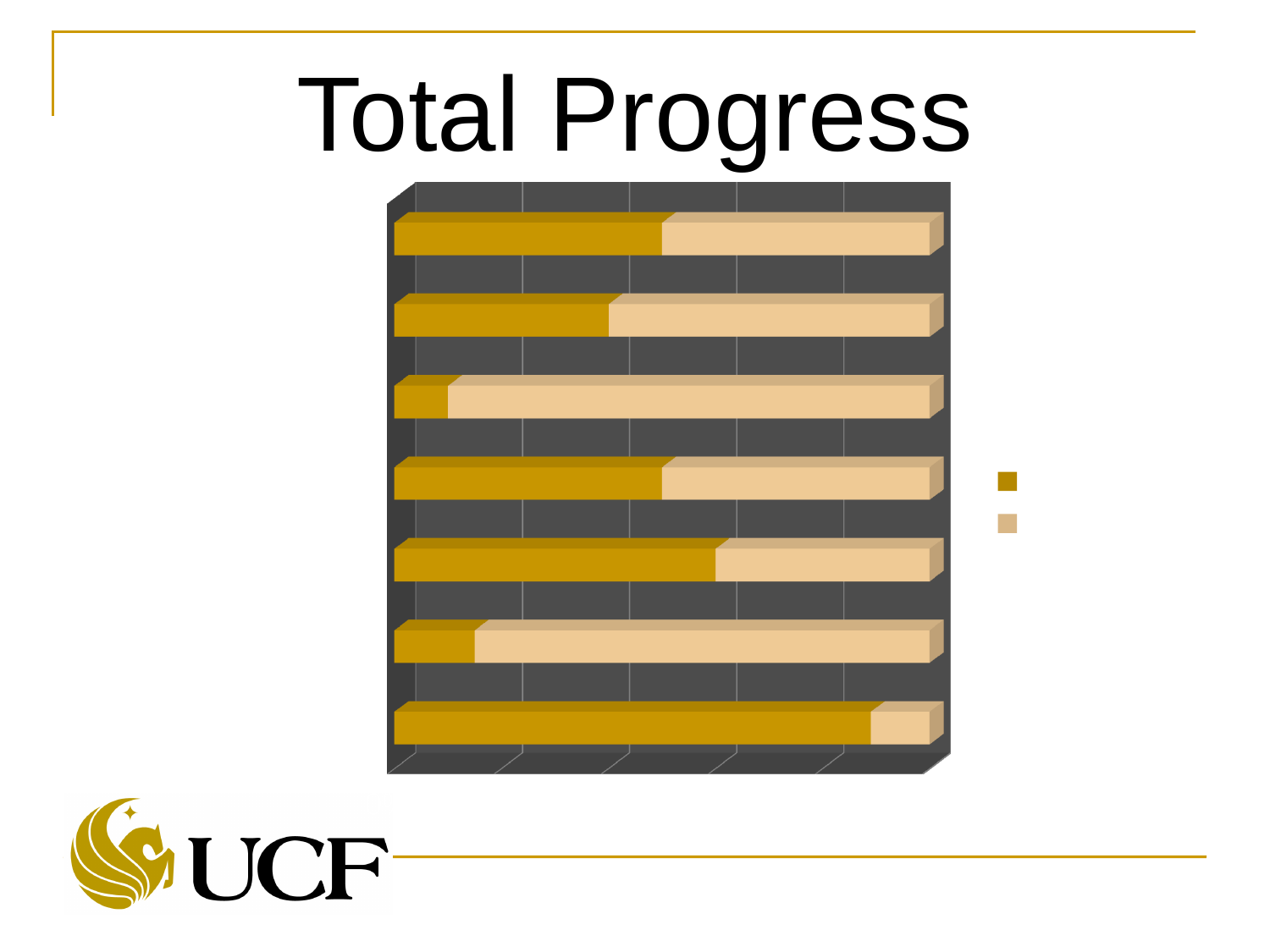
What is the title shown above the chart? Total Progress What kind of chart is shown on the slide? stacked bar chart Is the dark gold segment longer in the fifth bar or the sixth bar from the top? the fifth bar How many bars are plotted in the chart? 7 Which bar, counting from the top, has the shortest dark gold segment? the third bar What two colours are used for the segments of the bars? dark gold and light tan Is the light tan segment longer in the sixth bar or the seventh bar from the top? the sixth bar Is the dark gold segment longer in the first bar or the third bar from the top? the first bar How many series does the legend list? 2 Which bar, counting from the top, has the longest dark gold segment? the seventh (bottom) bar Which bar, counting from the top, has the shortest light tan segment? the seventh (bottom) bar Which bar, counting from the top, has the longest light tan segment? the third bar